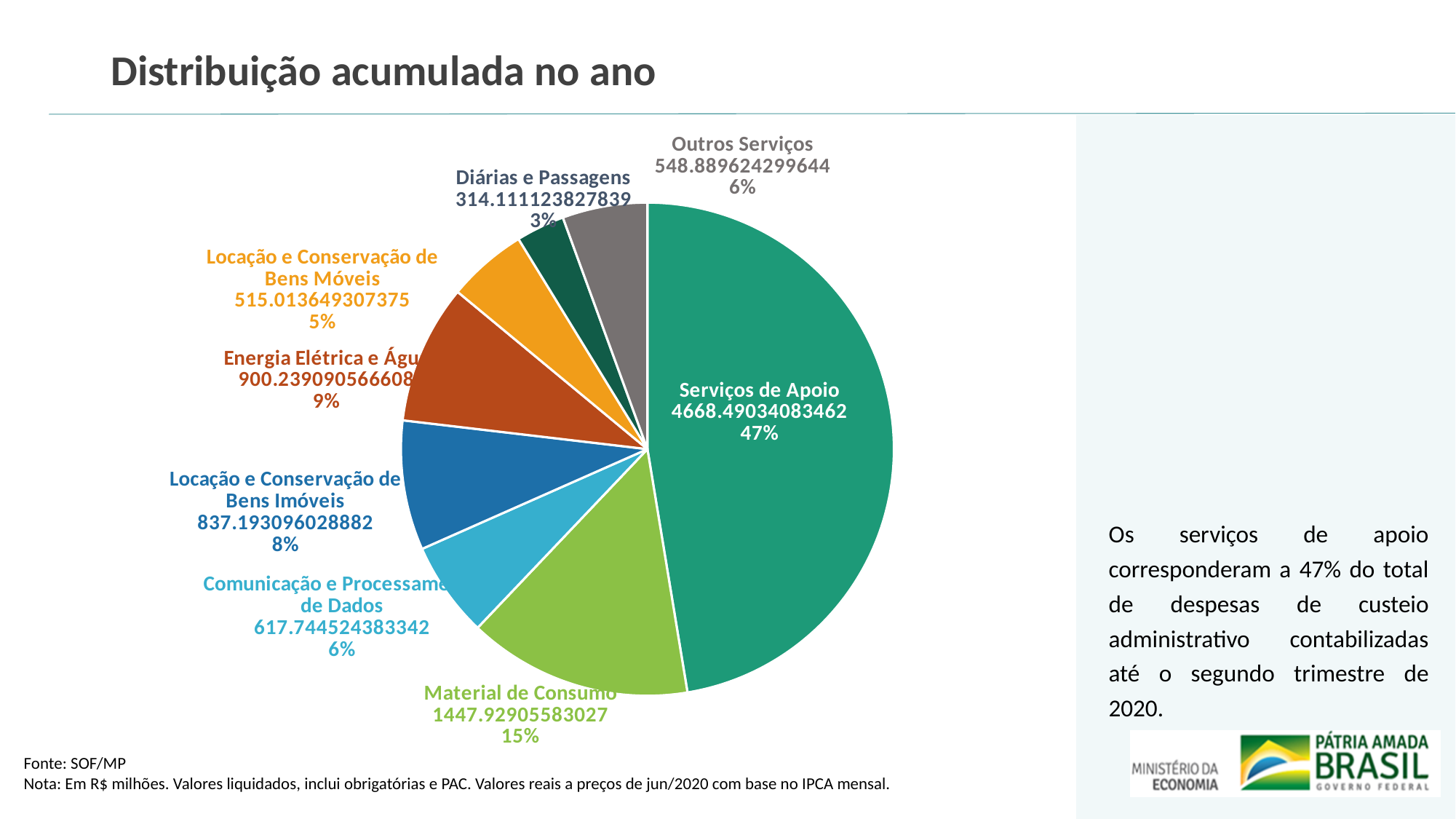
What percentage share is shown for Locação e Conservação de Bens Imóveis? 8% What share of the pie does Material de Consumo represent? 15% What is the value shown for Serviços de Apoio? 4668.49034083462 By how many percentage points does the share of Serviços de Apoio exceed the share of Material de Consumo? 32 percentage points What kind of chart is shown on the slide? Pie chart How many slices does the pie chart have? 8 Which category has the smallest slice of the pie? Diárias e Passagens Which is larger, the value for Outros Serviços or the value for Locação e Conservação de Bens Móveis? Outros Serviços What is the value shown for Diárias e Passagens? 314.111123827839 Which category has the largest slice of the pie? Serviços de Apoio What is the title of the chart? Distribuição acumulada no ano What is the value shown for Energia Elétrica e Água? 900.239090566608